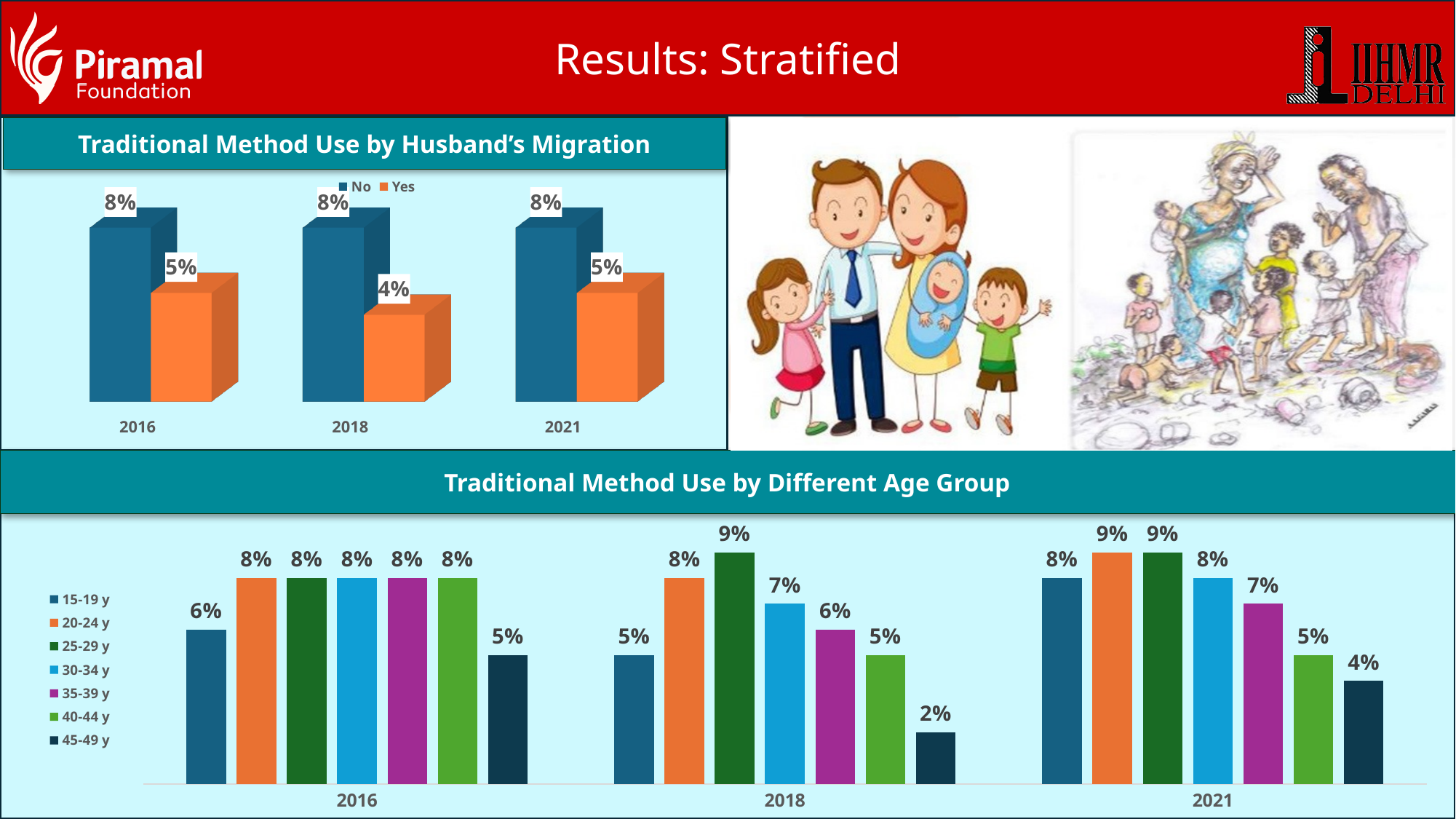
In the 'Traditional Method Use by Different Age Group' chart, what is the value for the 45-49 y group in 2018? 2% What type of chart is 'Traditional Method Use by Different Age Group'? Bar chart In the 'Traditional Method Use by Husband's Migration' chart, what is the difference between 'No' and 'Yes' in 2016? 3% In the 'Traditional Method Use by Husband's Migration' chart, what is the value for 'Yes' in 2018? 4% In the 'Traditional Method Use by Husband's Migration' chart, how many series does the legend list? 2 In the 'Traditional Method Use by Different Age Group' chart, what is the value for the 35-39 y group in 2021? 7% In the 'Traditional Method Use by Different Age Group' chart, which age group has the lowest value in 2021? 45-49 y In the 'Traditional Method Use by Different Age Group' chart, which is larger in 2018: the 25-29 y group or the 30-34 y group? 25-29 y In the 'Traditional Method Use by Different Age Group' chart, how many age groups does the legend list? 7 In the 'Traditional Method Use by Different Age Group' chart, what is the difference between the 20-24 y group and the 45-49 y group in 2018? 6% In the 'Traditional Method Use by Husband's Migration' chart, how many years are shown on the x axis? 3 In the 'Traditional Method Use by Husband's Migration' chart, what is the value for 'No' in 2021? 8%